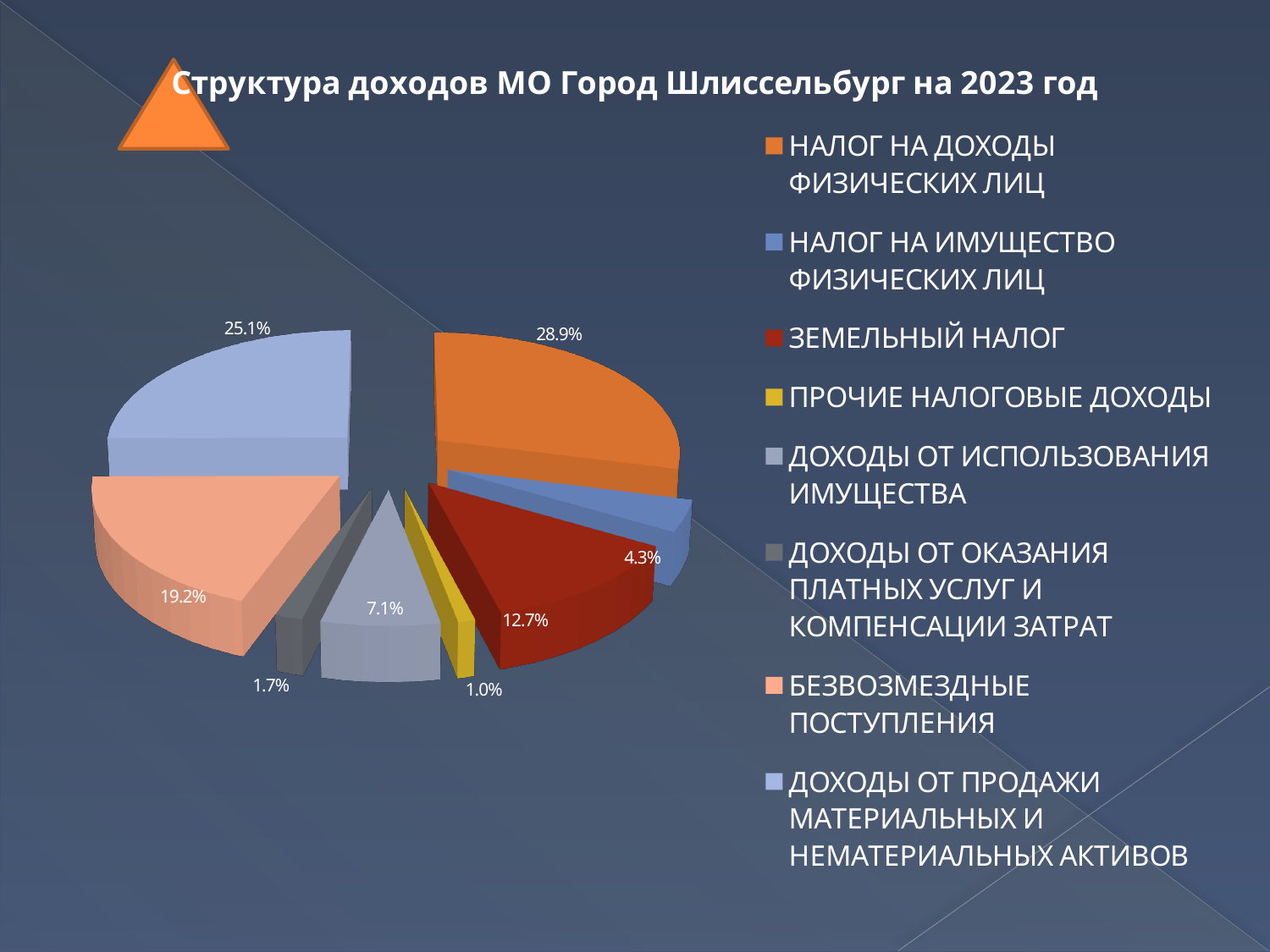
What is the title of the chart? Структура доходов МО Город Шлиссельбург на 2023 год What type of chart is shown on the slide? Pie chart What is the difference in percentage points between НАЛОГ НА ДОХОДЫ ФИЗИЧЕСКИХ ЛИЦ and ДОХОДЫ ОТ ПРОДАЖИ МАТЕРИАЛЬНЫХ И НЕМАТЕРИАЛЬНЫХ АКТИВОВ? 3.8% Which category has the largest share of the pie? НАЛОГ НА ДОХОДЫ ФИЗИЧЕСКИХ ЛИЦ What colour is the slice for ЗЕМЕЛЬНЫЙ НАЛОГ? Dark red What share of revenue comes from ЗЕМЕЛЬНЫЙ НАЛОГ? 12.7% What share of revenue comes from БЕЗВОЗМЕЗДНЫЕ ПОСТУПЛЕНИЯ? 19.2% How many categories does the legend list? 8 Which category has the smallest share of the pie? ПРОЧИЕ НАЛОГОВЫЕ ДОХОДЫ What share of revenue comes from НАЛОГ НА ИМУЩЕСТВО ФИЗИЧЕСКИХ ЛИЦ? 4.3% What share of revenue comes from НАЛОГ НА ДОХОДЫ ФИЗИЧЕСКИХ ЛИЦ? 28.9% Which is larger: the share for ЗЕМЕЛЬНЫЙ НАЛОГ or the share for ДОХОДЫ ОТ ИСПОЛЬЗОВАНИЯ ИМУЩЕСТВА? ЗЕМЕЛЬНЫЙ НАЛОГ